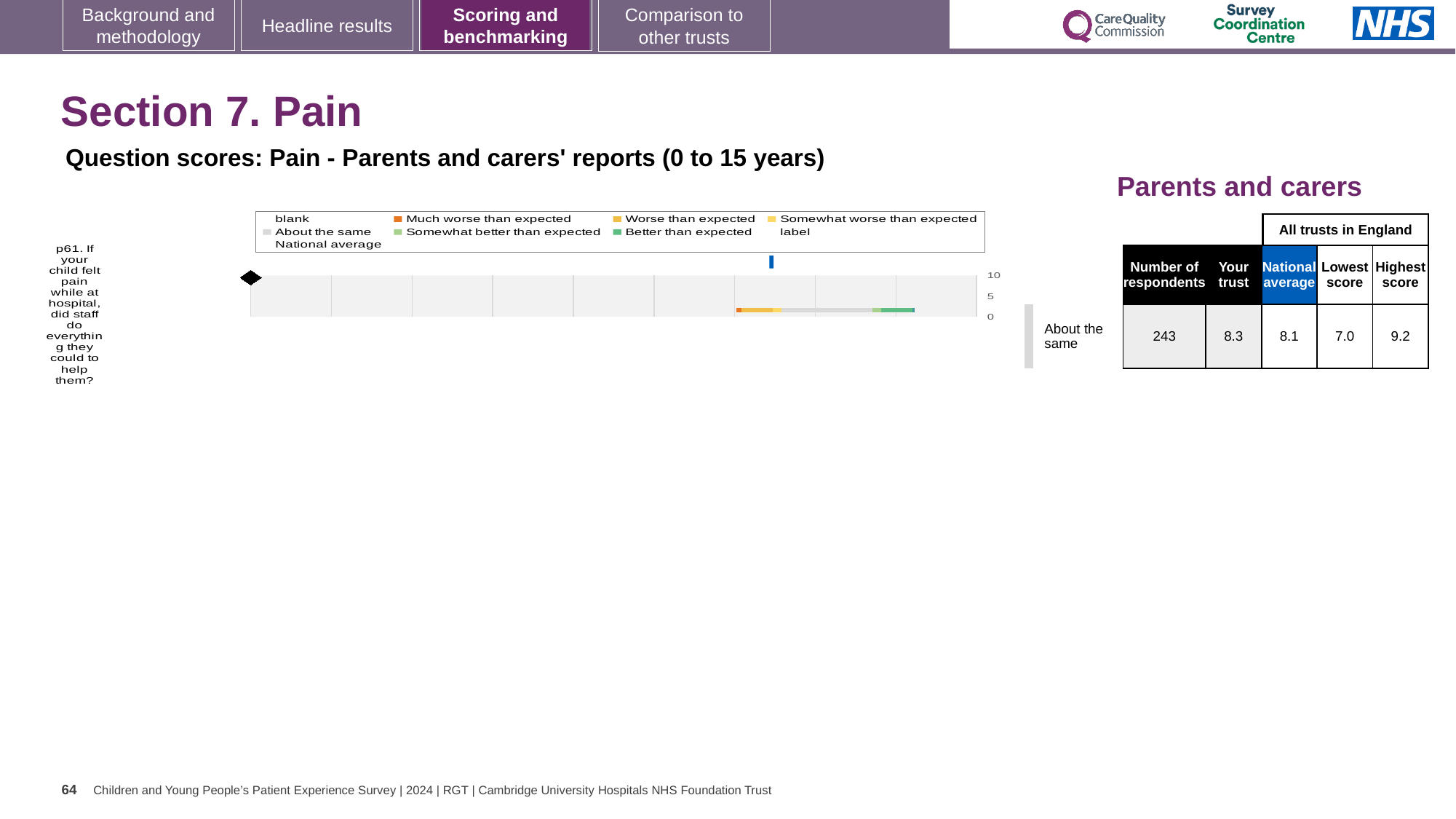
Which is larger for question p61: the 'Your trust' score or the national average? Your trust According to the table beside the chart, what is the lowest score among all trusts in England for question p61? 7.0 What kind of chart is shown on the slide? bar chart According to the table beside the chart, how many respondents answered question p61? 243 What is the highest value shown on the chart's score axis? 10 What is the difference between the highest score and the lowest score for question p61? 2.2 According to the table beside the chart, what is the national average score for question p61? 8.1 How many survey questions are plotted in the chart? 1 According to the table beside the chart, what is the 'Your trust' score for question p61? 8.3 According to the table beside the chart, what is the highest score among all trusts in England for question p61? 9.2 Which legend entry is shown in orange? Much worse than expected What is the difference between the 'Your trust' score and the national average for question p61? 0.2